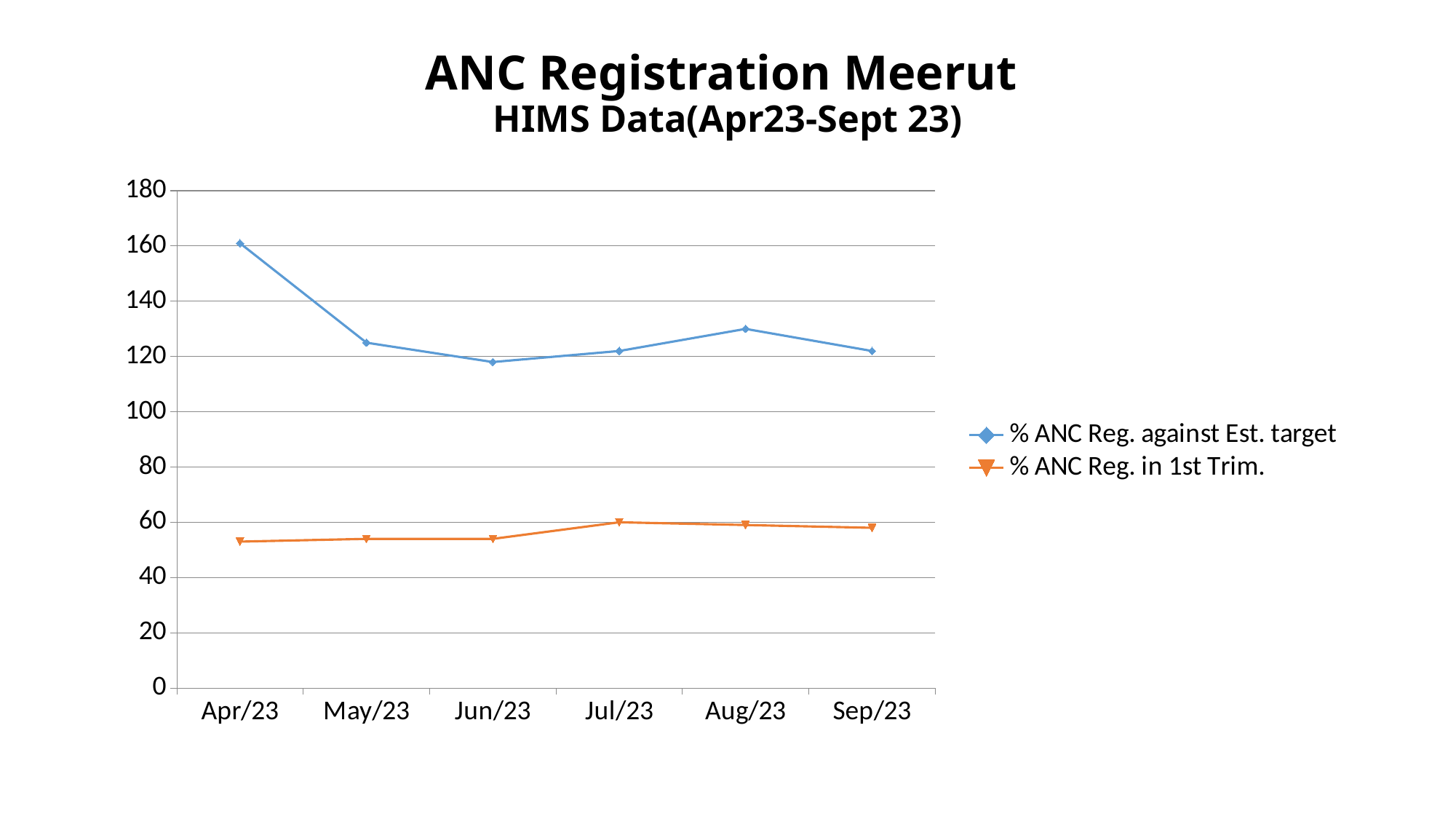
What is the title of the chart? ANC Registration Meerut HIMS Data(Apr23-Sept 23) Is the value for % ANC Reg. in 1st Trim. in Apr/23 greater or less than 60? less Is the value for % ANC Reg. against Est. target in Aug/23 greater or less than 120? greater Is the value for % ANC Reg. against Est. target in Apr/23 greater or less than 140? greater How many series does the legend list? 2 In which month is the value for % ANC Reg. against Est. target highest? Apr/23 Which is larger for % ANC Reg. against Est. target: Apr/23 or May/23? Apr/23 In Sep/23, which series has the larger value: % ANC Reg. against Est. target or % ANC Reg. in 1st Trim.? % ANC Reg. against Est. target What kind of chart is shown on the slide? line chart How many months are plotted along the x axis? 6 Does the % ANC Reg. against Est. target line rise or fall from Apr/23 to Jun/23? fall